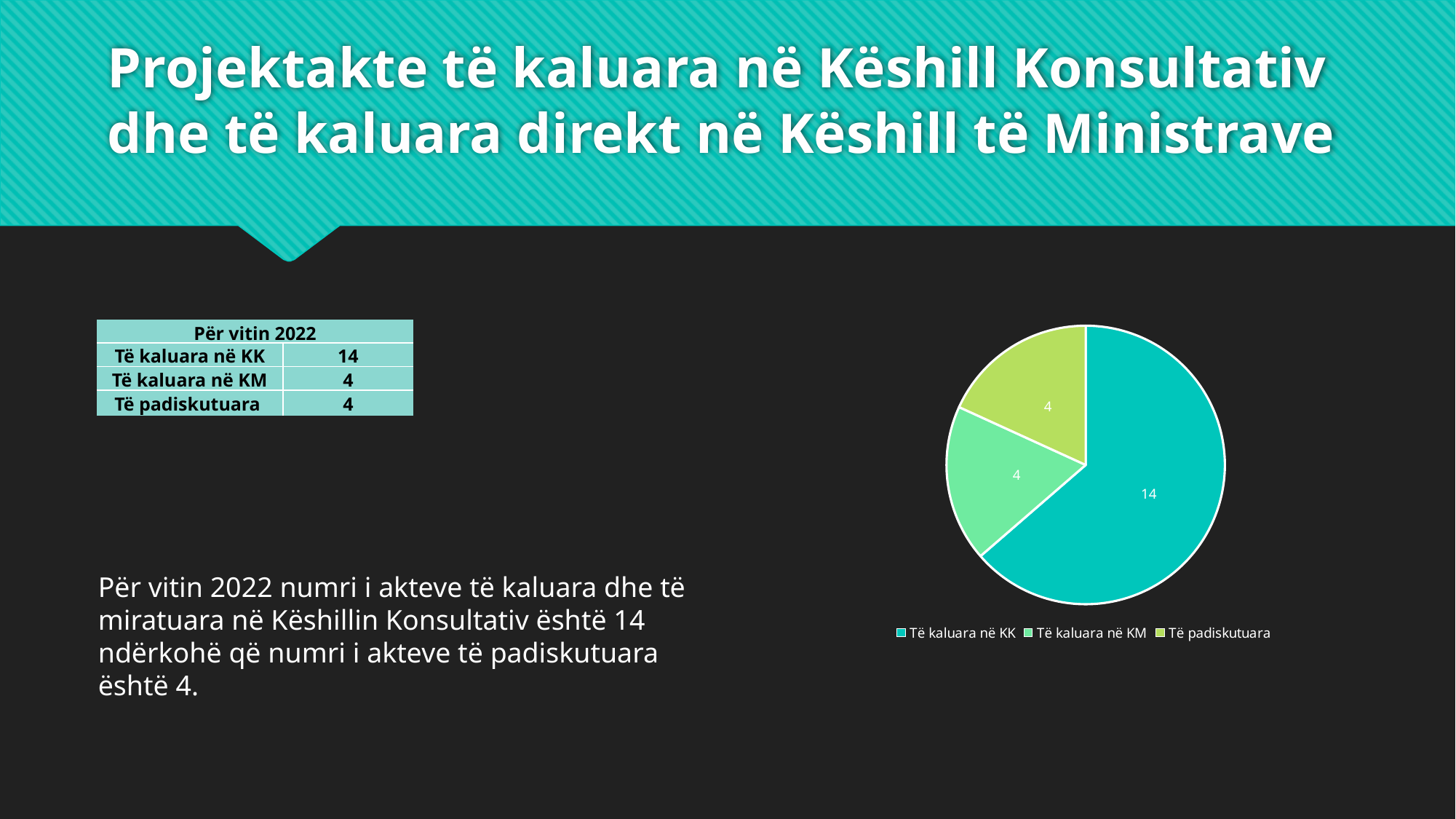
How many entries does the pie chart's legend list? 3 Which is larger in the pie chart, 'Të kaluara në KK' or 'Të padiskutuara'? Të kaluara në KK What is the total of all slices in the pie chart? 22 Which category has the largest slice in the pie chart? Të kaluara në KK Which colour represents 'Të padiskutuara' in the pie chart? Yellow-green What is the value of the 'Të padiskutuara' slice in the pie chart? 4 What type of chart is shown on the slide? Pie chart What is the difference between the 'Të kaluara në KK' value and the 'Të kaluara në KM' value in the pie chart? 10 What is the value of the 'Të kaluara në KM' slice in the pie chart? 4 How many slices does the pie chart have? 3 What is the value of the 'Të kaluara në KK' slice in the pie chart? 14 What fraction of the pie chart total does the 'Të kaluara në KK' slice represent? 14 out of 22